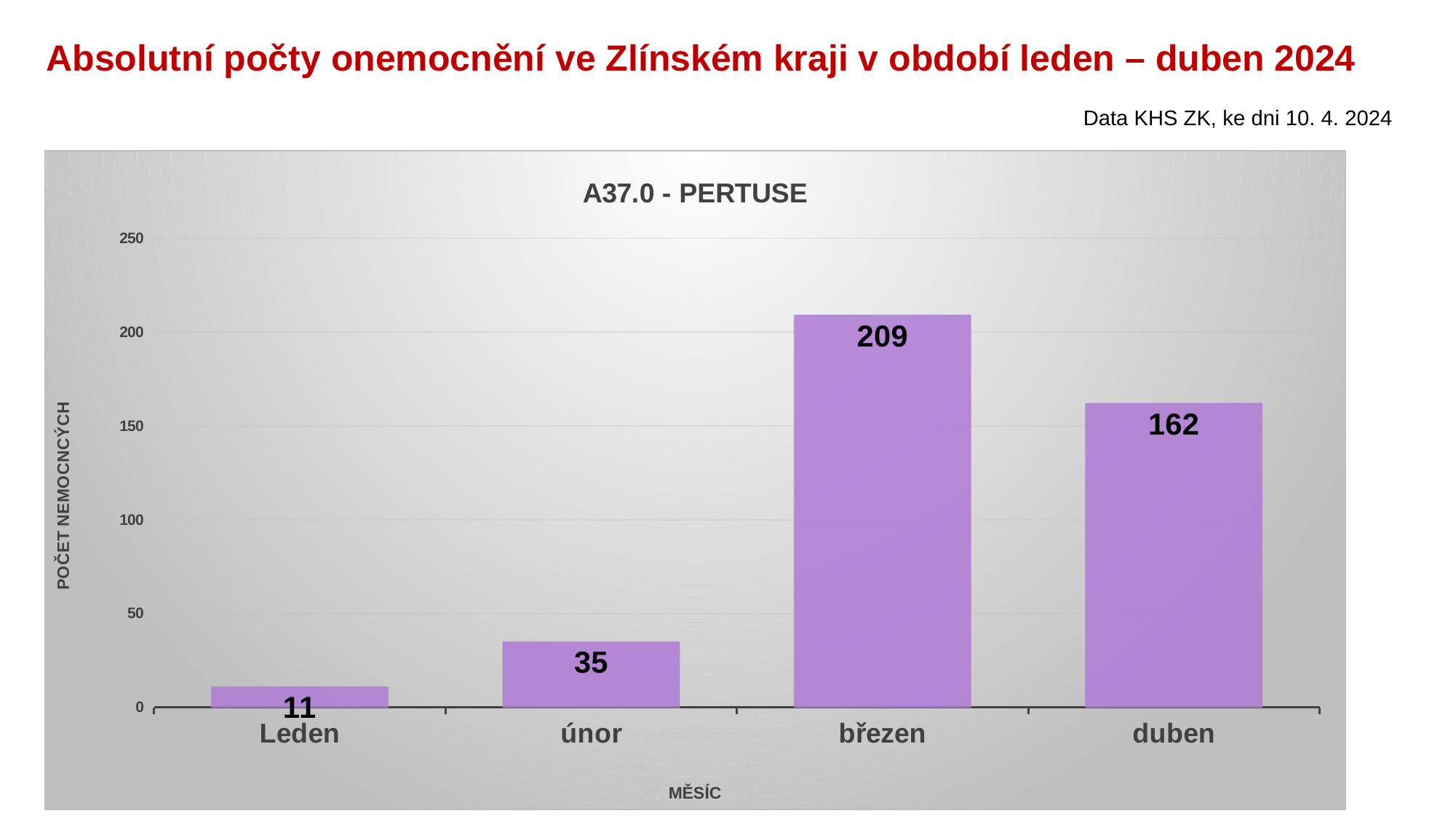
What kind of chart is shown? bar chart What is the value for duben? 162 How many months are shown on the x axis? 4 What is the value for březen? 209 Which month has the lowest value? Leden Which month has the highest value? březen What is the difference between the values for březen and duben? 47 Which is larger, the value for únor or the value for duben? duben What is the title of the chart? A37.0 - PERTUSE Is the value for duben greater or less than 150? greater What is the value for Leden? 11 What is the value for únor? 35